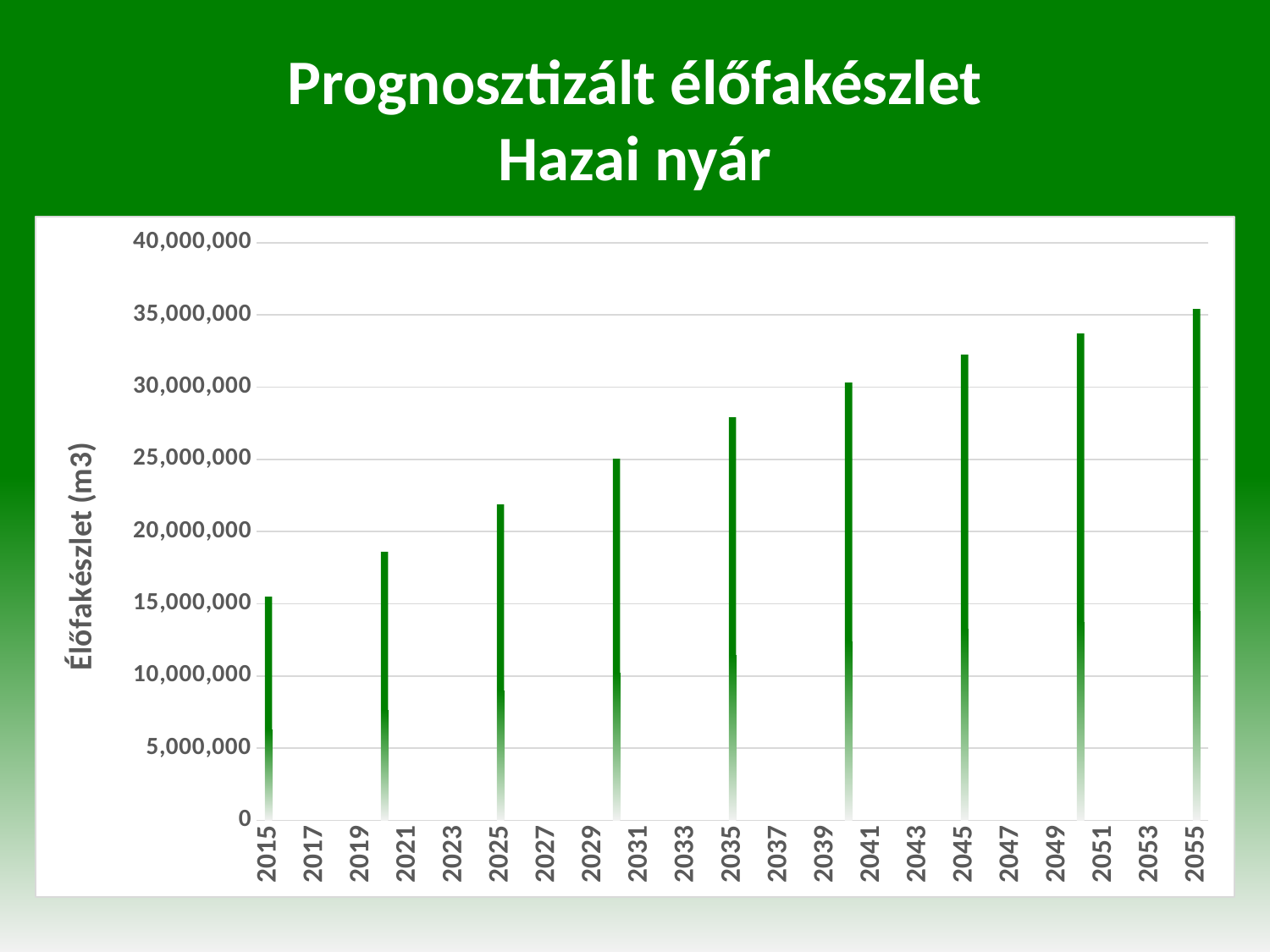
Is the value for 2015 greater or less than 20,000,000? less What is the label of the vertical axis? Élőfakészlet (m3) Is the value for 2045 greater or less than 30,000,000? greater Which is larger, the value for 2045 or the value for 2025? 2045 Which year has the lowest bar? 2015 What kind of chart is shown on the slide? bar chart Is the value for 2025 greater or less than 20,000,000? greater Do the values rise or fall from 2015 to 2055? rise How many bars are plotted in the chart? 9 Which year has the highest bar? 2055